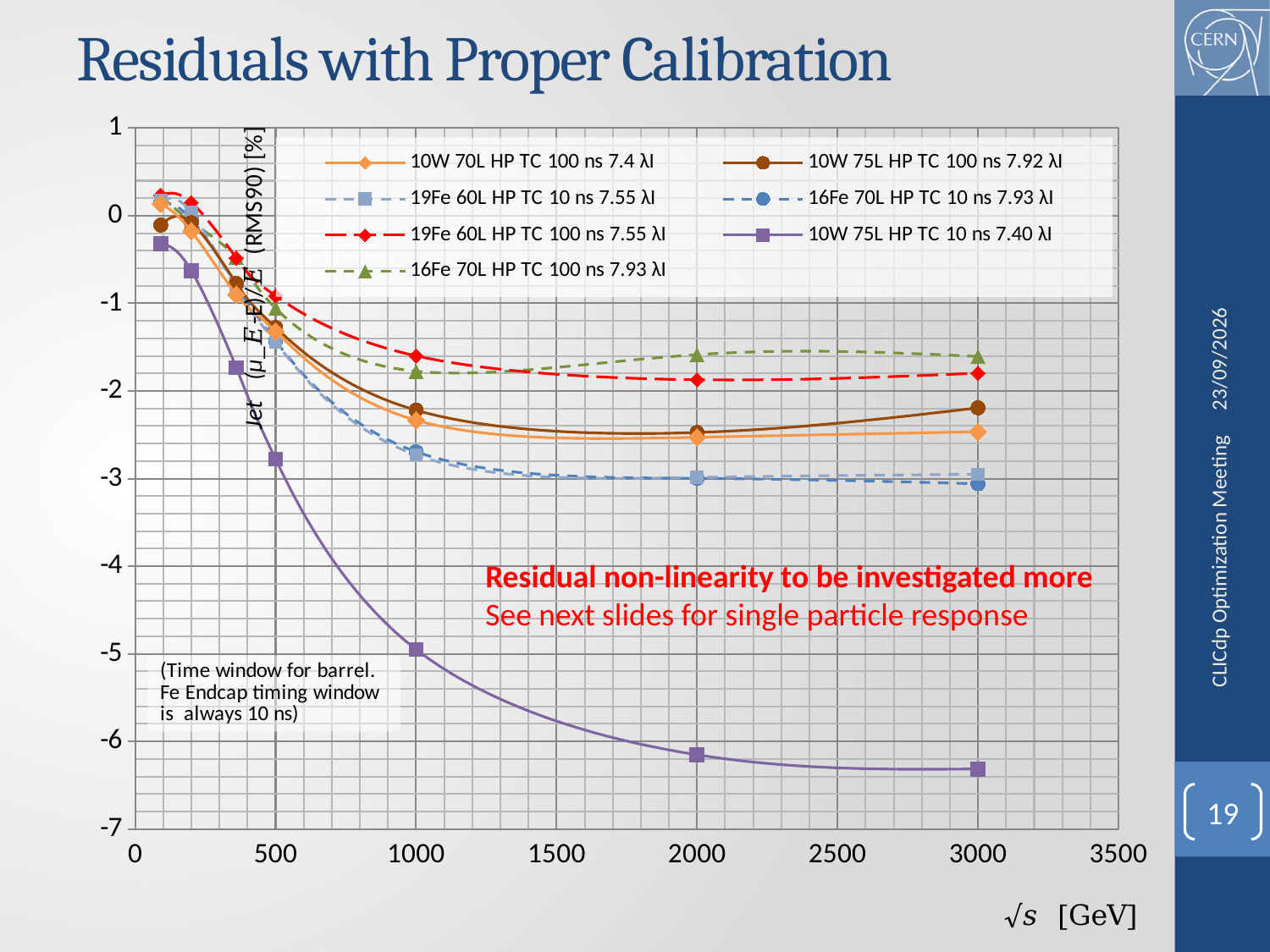
Which series has the lowest value at 3000 GeV? 10W 75L HP TC 10 ns 7.40 λI Is the value for the 19Fe 60L HP TC 100 ns 7.55 λI series at 3000 GeV greater or less than -2? greater What kind of chart is shown on the slide? line chart What is the title of the slide containing the chart? Residuals with Proper Calibration What is the label of the x axis? √s [GeV] Is the value for the 10W 75L HP TC 10 ns 7.40 λI series at 3000 GeV greater or less than -6? less Which series has the highest value at 3000 GeV? 16Fe 70L HP TC 100 ns 7.93 λI Is the value for the 10W 70L HP TC 100 ns 7.4 λI series at 2000 GeV greater or less than -2? less Does the 10W 75L HP TC 10 ns 7.40 λI series rise or fall as √s increases from 500 to 3000 GeV? fall At 3000 GeV, which is larger: the value for 16Fe 70L HP TC 100 ns 7.93 λI or for 10W 75L HP TC 10 ns 7.40 λI? 16Fe 70L HP TC 100 ns 7.93 λI How many series does the legend list? 7